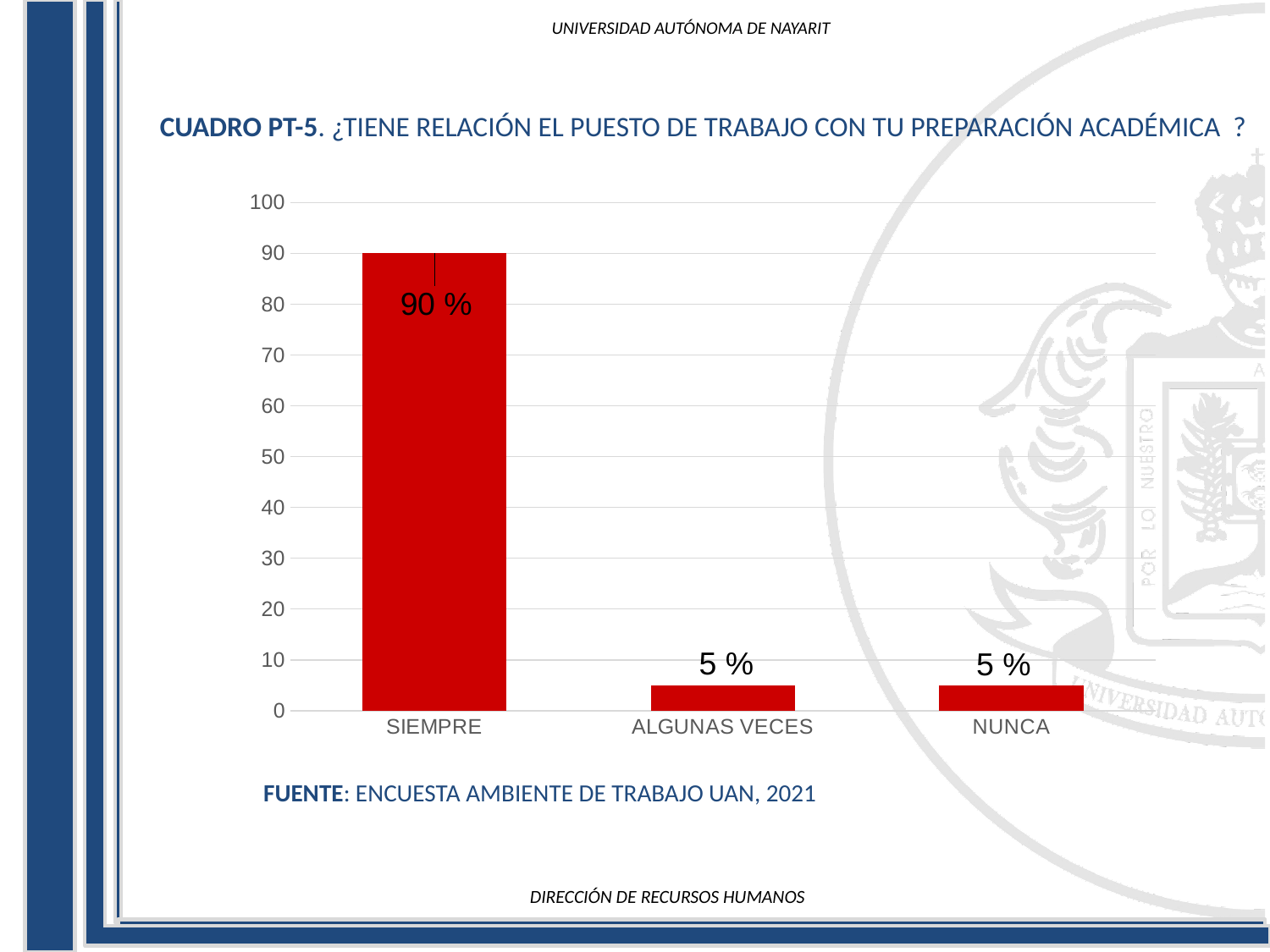
How many categories are shown on the x axis? 3 What is the value for SIEMPRE? 90 % What is the difference between the values for SIEMPRE and NUNCA? 85 % What is the value for NUNCA? 5 % Which is larger, the value for SIEMPRE or the value for ALGUNAS VECES? SIEMPRE Which category has the highest value? SIEMPRE What kind of chart is shown on the slide? bar chart What is the highest value shown on the y axis? 100 Is the value for SIEMPRE greater or less than 50? greater Is the value for NUNCA greater or less than 10? less What is the value for ALGUNAS VECES? 5 % What is the source cited below the chart? ENCUESTA AMBIENTE DE TRABAJO UAN, 2021